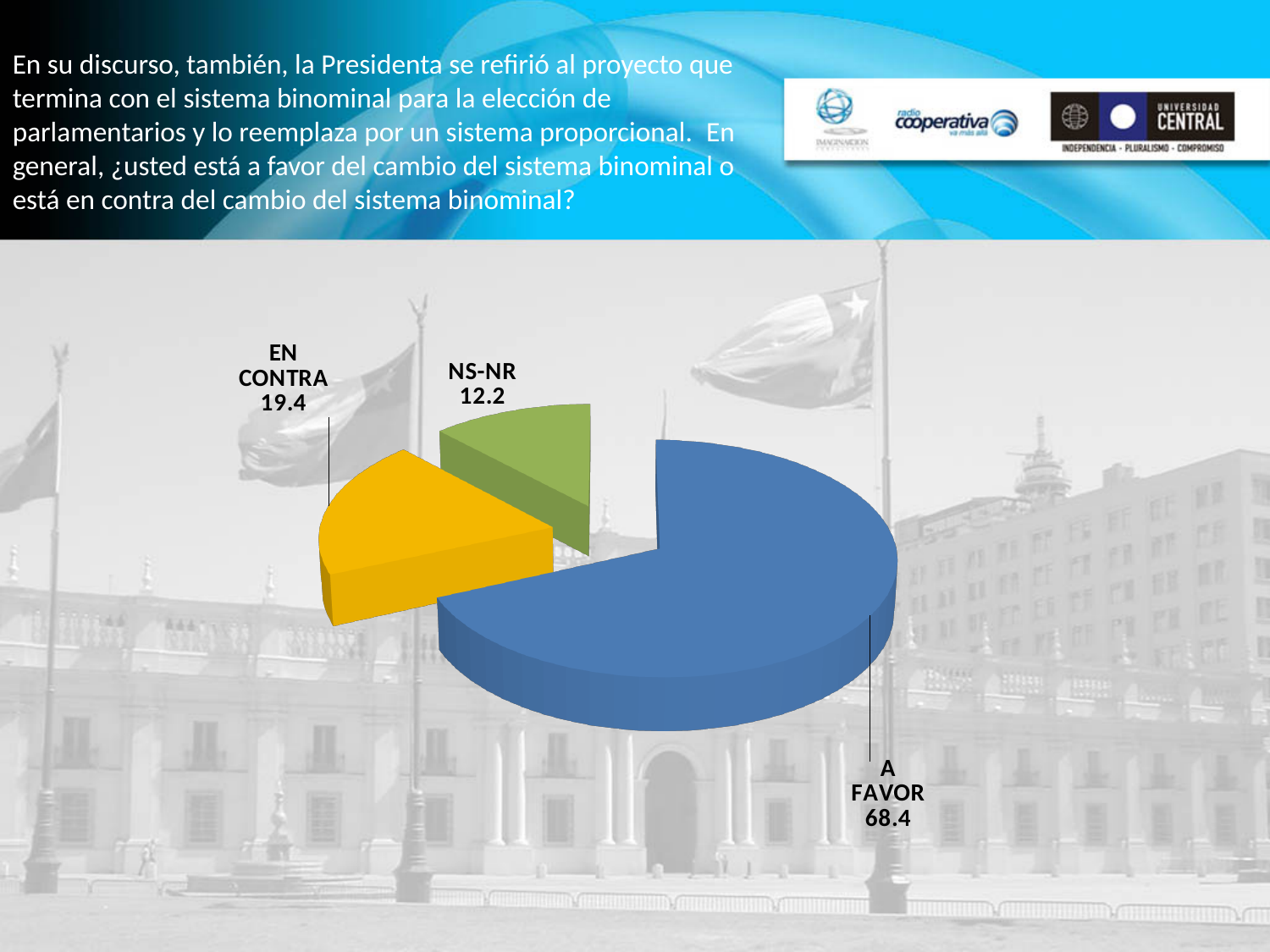
What kind of chart is shown on the slide? pie chart How many slices does the pie chart have? 3 What is the value for NS-NR? 12.2 What is the difference between the values for A FAVOR and EN CONTRA? 49.0 What is the value for EN CONTRA? 19.4 Which category has the largest slice? A FAVOR What colour is the A FAVOR slice? blue Which is larger, EN CONTRA or NS-NR? EN CONTRA What is the difference between the values for EN CONTRA and NS-NR? 7.2 What colour is the NS-NR slice? green Which category has the smallest slice? NS-NR What is the value for A FAVOR? 68.4